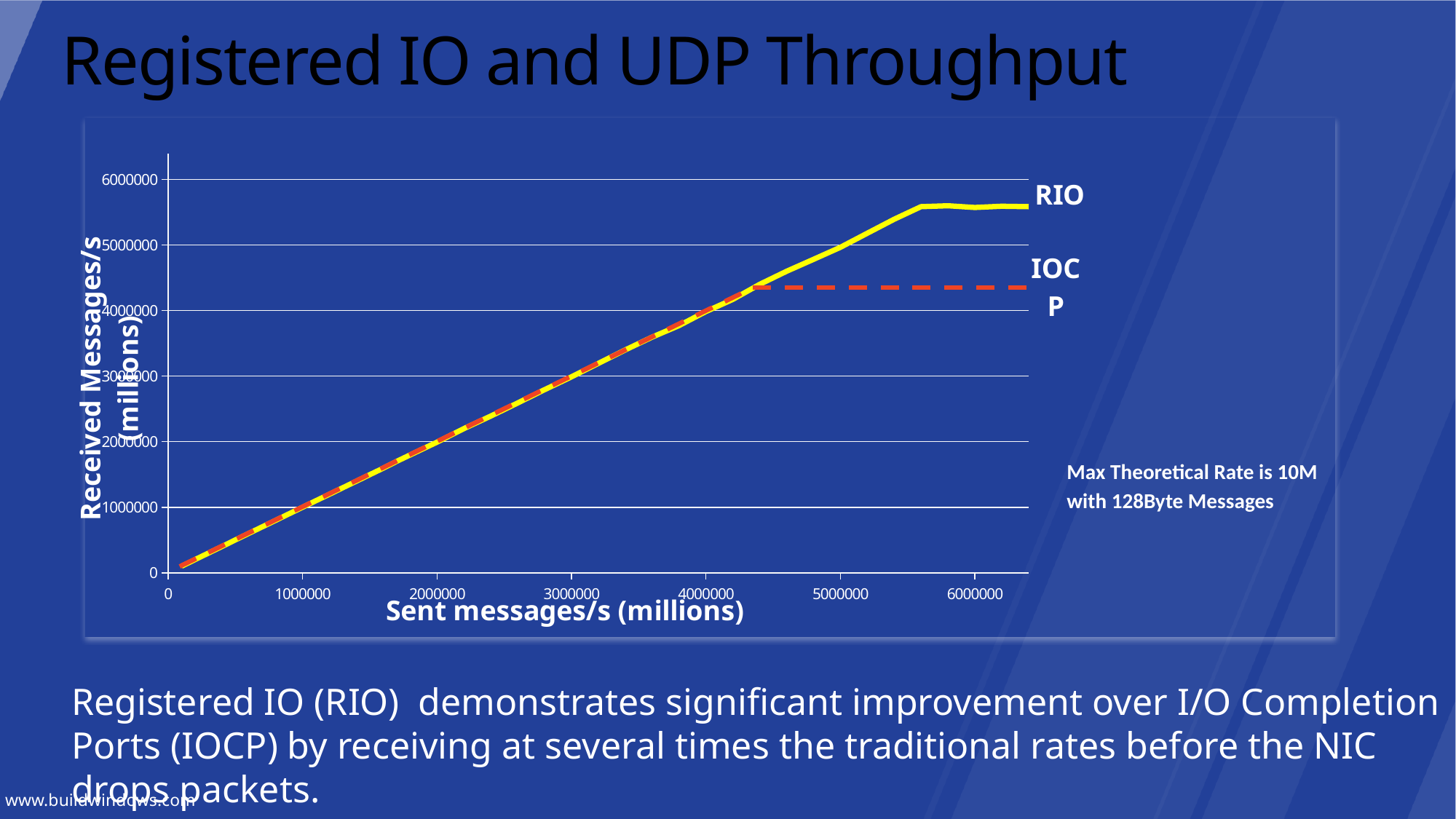
Which series reaches the highest received messages/s on the chart? RIO How many series are plotted on the chart? 2 What is the title of the chart's x axis? Sent messages/s (millions) What is the title of the chart's y axis? Received Messages/s (millions) At 6000000 sent messages/s, is the RIO value greater or less than 5000000 received messages/s? greater At 6000000 sent messages/s, which series has the higher received messages/s, RIO or IOCP? RIO Which series is drawn as a red dashed line? IOCP Does the IOCP line rise or stay flat as sent messages/s increases from 5000000 to 6000000? stays flat Does the RIO line rise or fall as sent messages/s increases from 1000000 to 5000000? rise At 6000000 sent messages/s, is the IOCP value greater or less than 5000000 received messages/s? less What kind of chart is shown on the slide? line chart At 6000000 sent messages/s, is the IOCP value greater or less than 4000000 received messages/s? greater